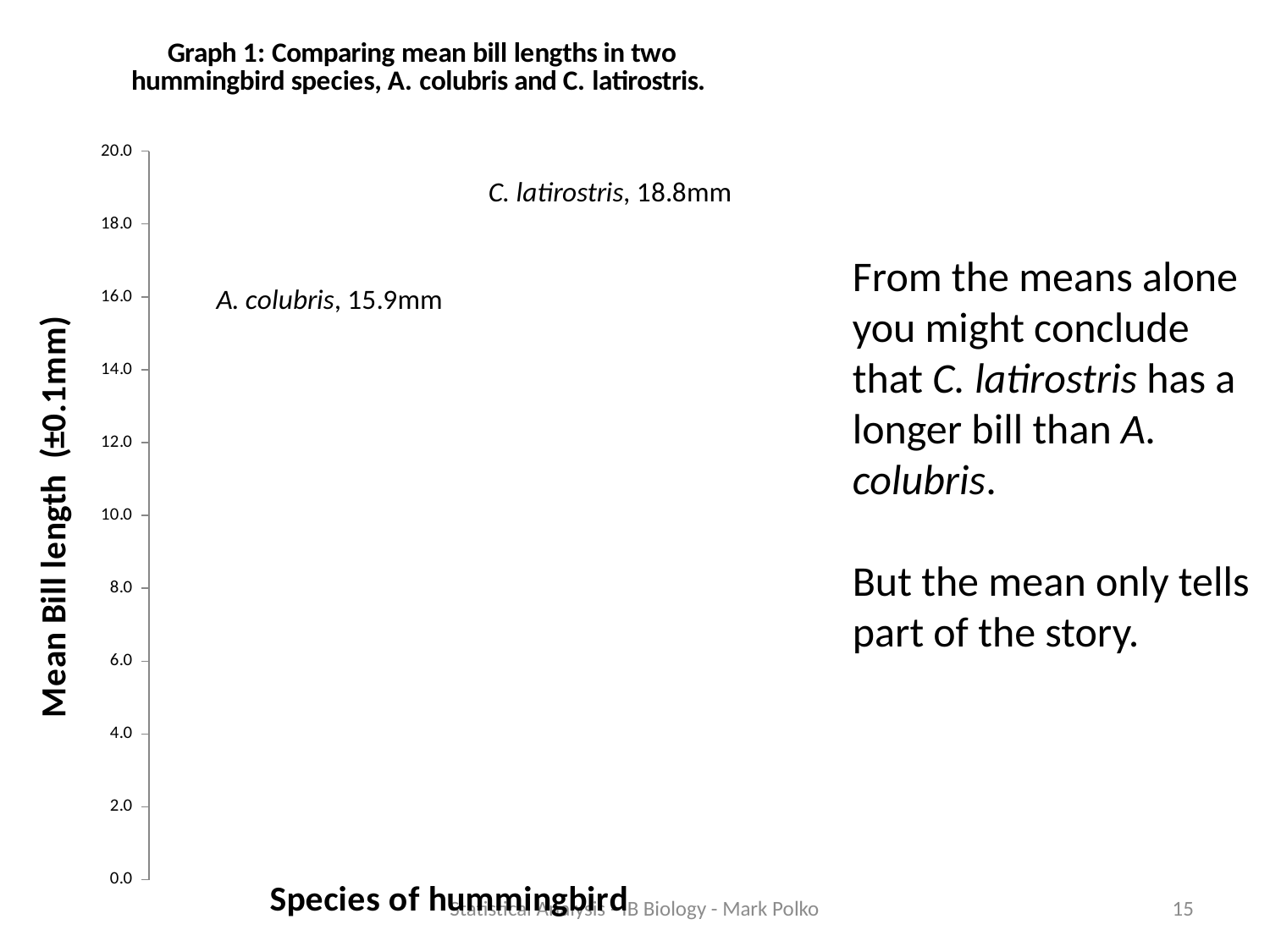
Is the mean bill length for C. latirostris greater or less than 18.0? greater Which species has the shorter mean bill length? A. colubris What is the label of the x-axis? Species of hummingbird Which species has the longer mean bill length? C. latirostris What is the label of the y-axis? Mean Bill length (±0.1mm) What is the maximum value shown on the y-axis? 20.0 Is the mean bill length of A. colubris larger or smaller than that of C. latirostris? smaller What is the difference between the mean bill lengths of C. latirostris and A. colubris? 2.9mm How many hummingbird species are compared in the chart? 2 What is the mean bill length for A. colubris? 15.9mm What is the mean bill length for C. latirostris? 18.8mm Is the mean bill length for A. colubris greater or less than 16.0? less